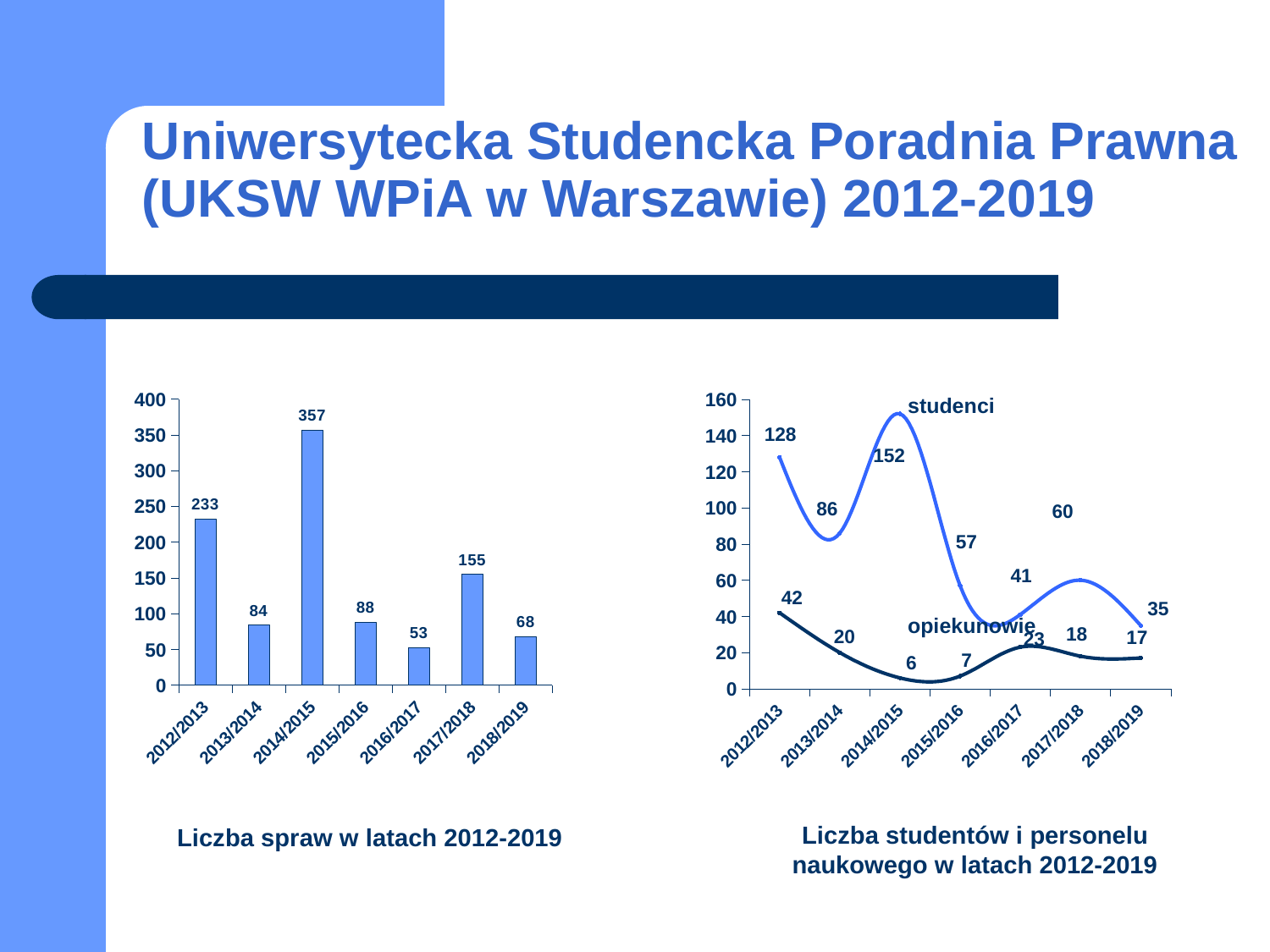
In the chart 'Liczba studentów i personelu naukowego w latach 2012-2019', what is the value for opiekunowie in 2016/2017? 23 In the chart 'Liczba spraw w latach 2012-2019', what is the difference between the values for 2012/2013 and 2013/2014? 149 In the chart 'Liczba studentów i personelu naukowego w latach 2012-2019', which year has the lowest value for opiekunowie? 2014/2015 In the chart 'Liczba spraw w latach 2012-2019', how many bars are shown? 7 In the chart 'Liczba studentów i personelu naukowego w latach 2012-2019', what is the difference between studenci and opiekunowie in 2012/2013? 86 In the chart 'Liczba spraw w latach 2012-2019', which year has the lowest value? 2016/2017 In the chart 'Liczba studentów i personelu naukowego w latach 2012-2019', what is the value for studenci in 2014/2015? 152 What kind of chart is 'Liczba spraw w latach 2012-2019'? Bar chart In the chart 'Liczba studentów i personelu naukowego w latach 2012-2019', which is larger in 2017/2018: studenci or opiekunowie? studenci In the chart 'Liczba spraw w latach 2012-2019', which year has the highest value? 2014/2015 What kind of chart is 'Liczba studentów i personelu naukowego w latach 2012-2019'? Line chart In the chart 'Liczba spraw w latach 2012-2019', what is the value for 2014/2015? 357